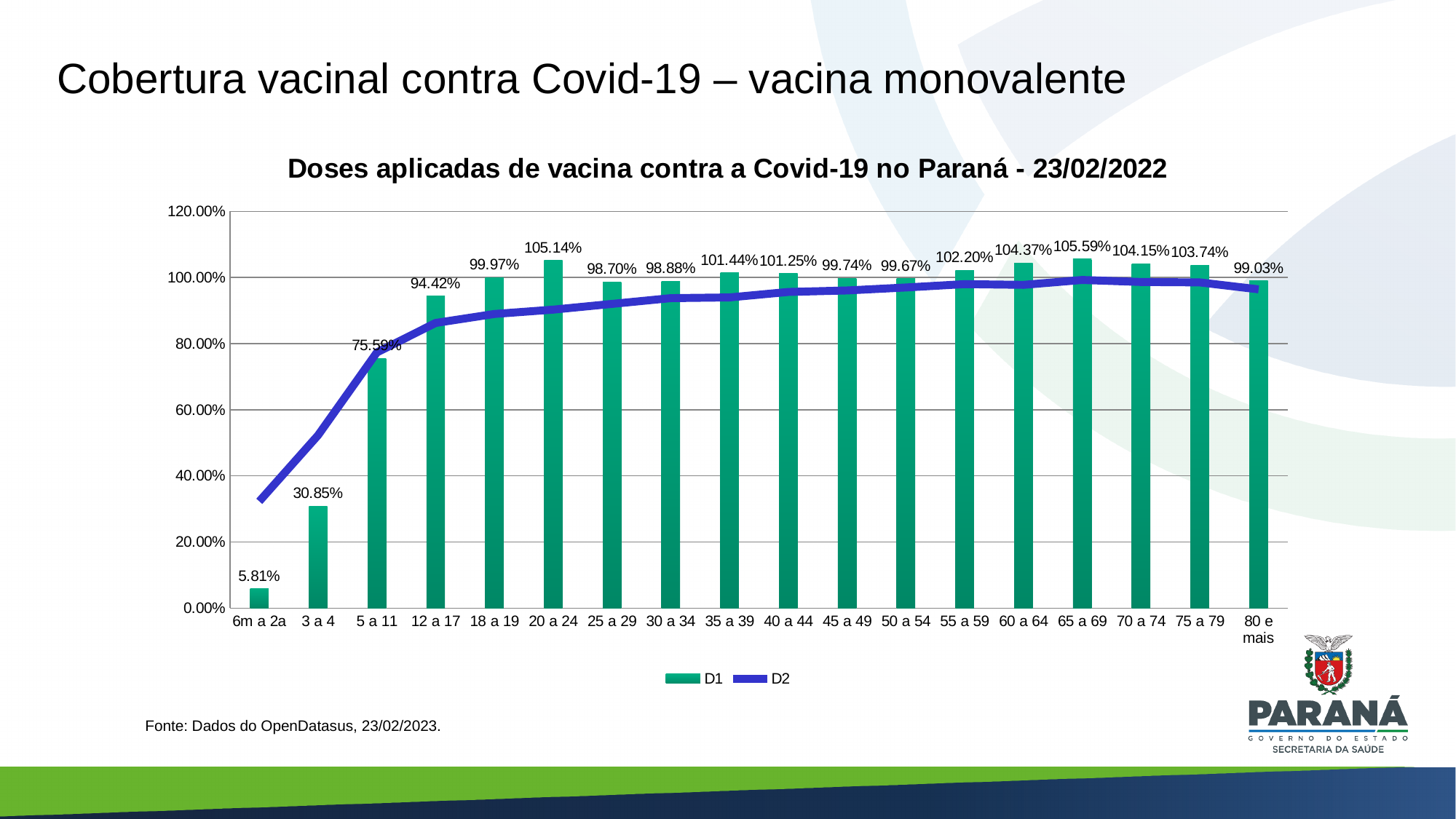
What is the D1 value for the 3 a 4 age group? 30.85% Which has a larger D1 value, 5 a 11 or 12 a 17? 12 a 17 How many age groups are shown on the x axis? 18 Is the D2 value for 6m a 2a greater or less than 40.00%? less What is the difference between the D1 values for 3 a 4 and 6m a 2a? 25.04% Which age group has the highest D1 value? 65 a 69 What is the D1 value for the 12 a 17 age group? 94.42% What is the title of the chart? Doses aplicadas de vacina contra a Covid-19 no Paraná - 23/02/2022 What is the D1 value for the 80 e mais age group? 99.03% Which age group has the lowest D1 value? 6m a 2a Is the D2 value for 80 e mais greater or less than 100.00%? less How many series does the legend list? 2